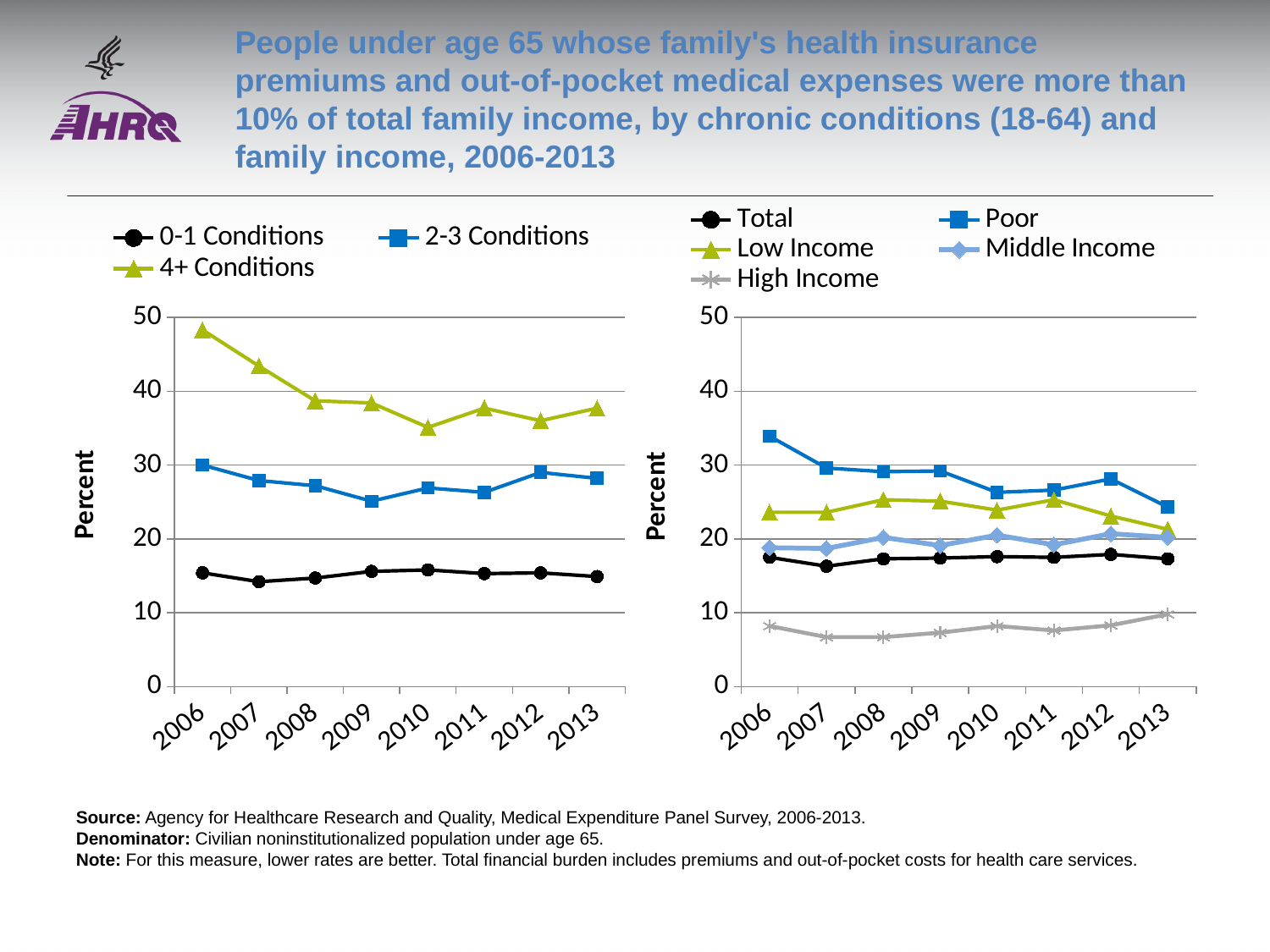
In the left chart (by chronic conditions), is the value for 4+ Conditions in 2006 greater or less than 40? greater In the right chart (by family income), is the value for Poor in 2006 greater or less than 30? greater In the left chart (by chronic conditions), which series has the highest value in 2006? 4+ Conditions How many series does the legend of the right chart (by family income) list? 5 In the left chart (by chronic conditions), is the value for 0-1 Conditions in 2010 greater or less than 20? less What is the label on the y axis of the right chart (by family income)? Percent How many years are shown on the x axis of the left chart (by chronic conditions)? 8 In the right chart (by family income), which is larger in 2006, Poor or Low Income? Poor In the right chart (by family income), which series has the lowest values across all years? High Income In the left chart (by chronic conditions), does the 4+ Conditions line rise or fall from 2006 to 2013? fall How many series does the legend of the left chart (by chronic conditions) list? 3 What kind of chart is the left chart (by chronic conditions)? line chart